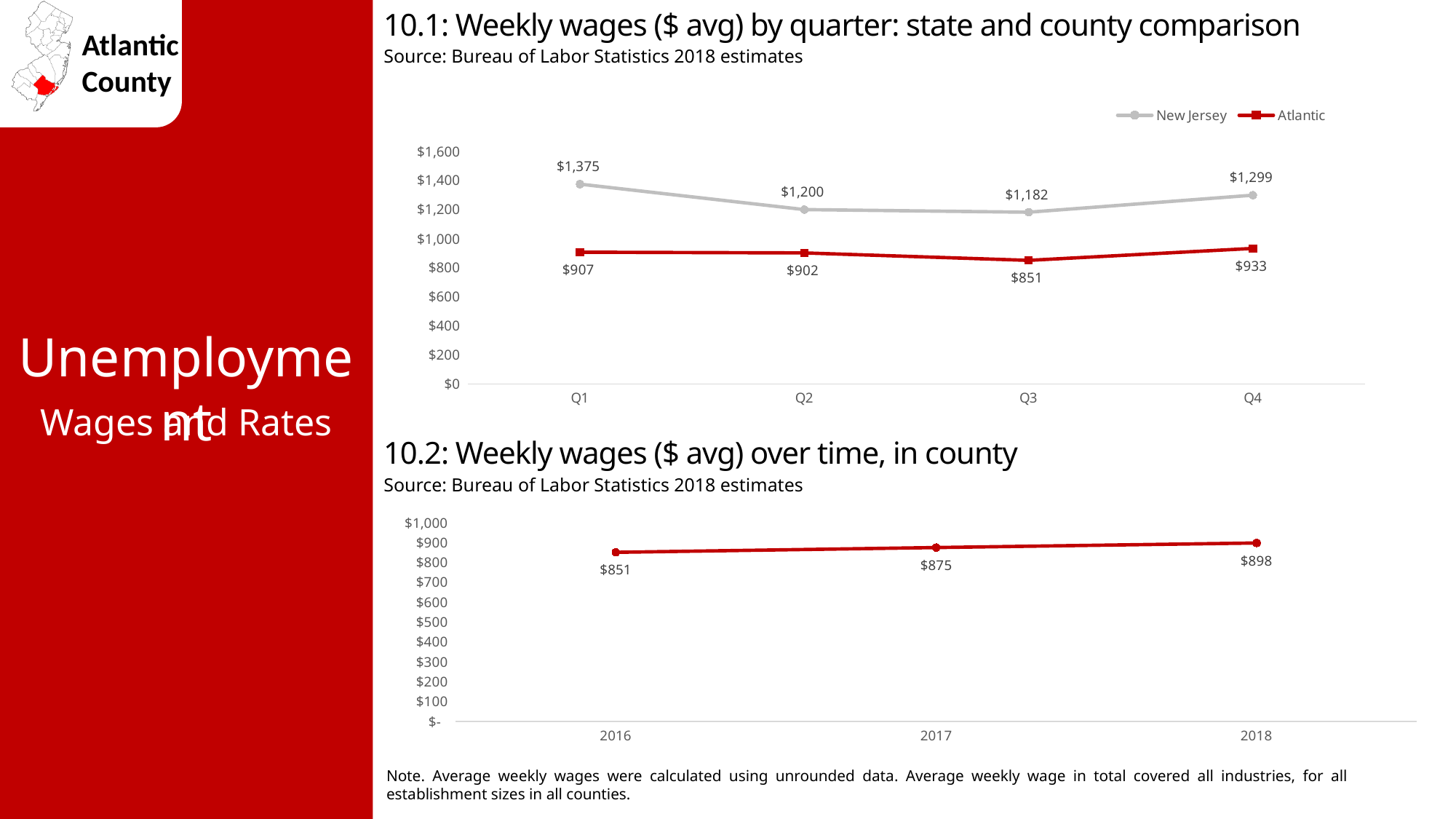
In chart 10.2 (weekly wages over time, in county), what is the difference between the 2018 and 2016 values? $47 In chart 10.2 (weekly wages over time, in county), do the values rise or fall from 2016 to 2018? Rise In chart 10.1 (weekly wages by quarter), what is the New Jersey value for Q1? $1,375 In chart 10.1 (weekly wages by quarter), what kind of chart is shown? Line chart In chart 10.2 (weekly wages over time, in county), what is the value for 2017? $875 In chart 10.1 (weekly wages by quarter), how many series does the legend list? 2 In chart 10.1 (weekly wages by quarter), what is the difference between the New Jersey and Atlantic values in Q4? $366 In chart 10.1 (weekly wages by quarter), which quarter has the lowest New Jersey value? Q3 In chart 10.1 (weekly wages by quarter), which quarter has the highest Atlantic value? Q4 In chart 10.1 (weekly wages by quarter), which series has the higher value in Q2, New Jersey or Atlantic? New Jersey In chart 10.1 (weekly wages by quarter), what is the Atlantic value for Q3? $851 In chart 10.2 (weekly wages over time, in county), how many years are plotted? 3